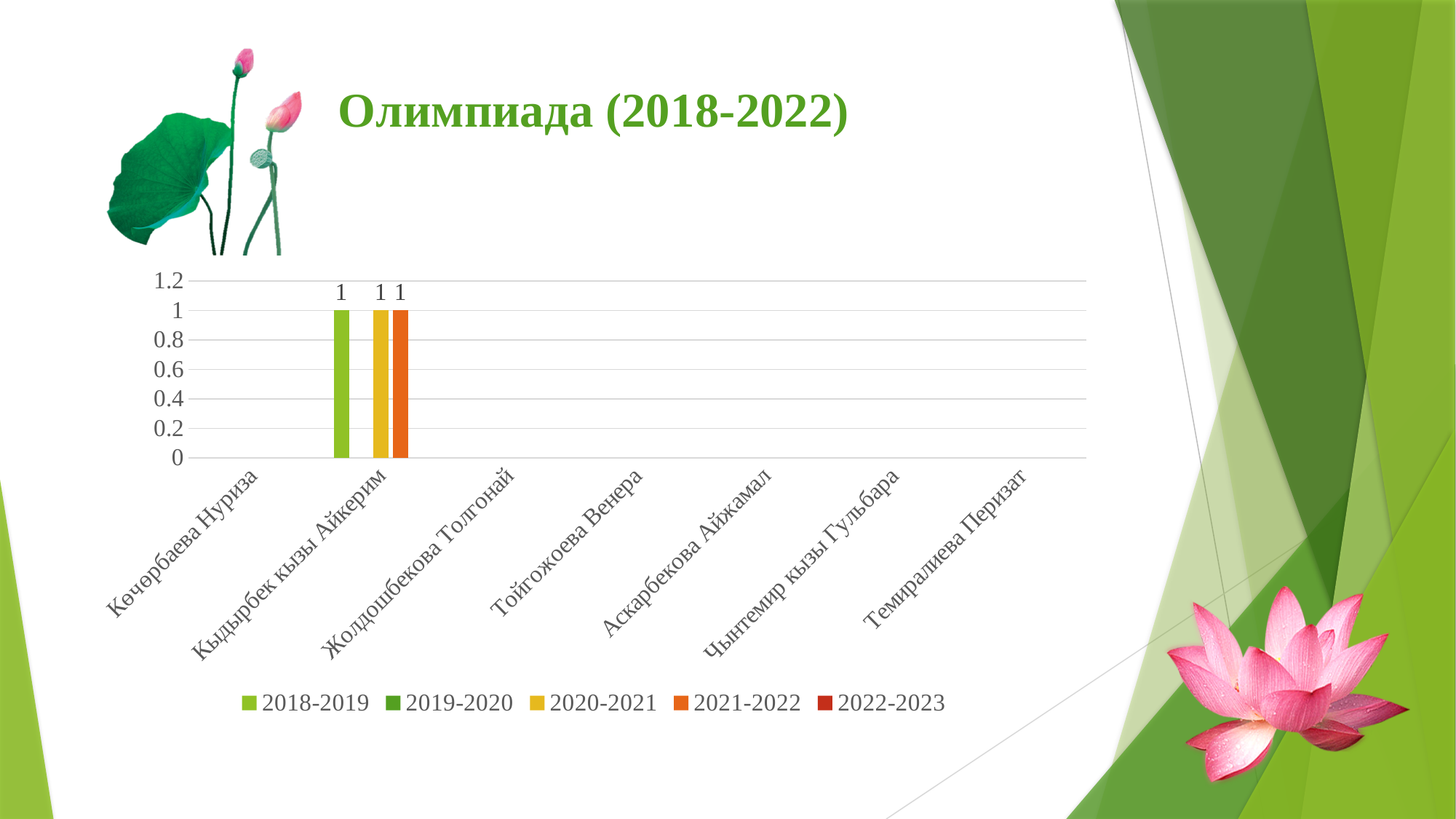
Is the value for Кыдырбек кызы Айкерим in 2018-2019 greater or less than 0.8? greater Which series is shown in orange in the legend? 2021-2022 What is the difference between the 2018-2019 and 2020-2021 values for Кыдырбек кызы Айкерим? 0 What kind of chart is shown on the slide? bar chart What is the value for Кыдырбек кызы Айкерим in the 2021-2022 series? 1 How many series does the legend list? 5 How many categories (names) are shown on the x axis? 7 What is the value for Кыдырбек кызы Айкерим in the 2020-2021 series? 1 What is the value for Кыдырбек кызы Айкерим in the 2018-2019 series? 1 What is the title of the chart? Олимпиада (2018-2022) Which category is the only one with visible bars? Кыдырбек кызы Айкерим Which category has the highest values in the chart? Кыдырбек кызы Айкерим